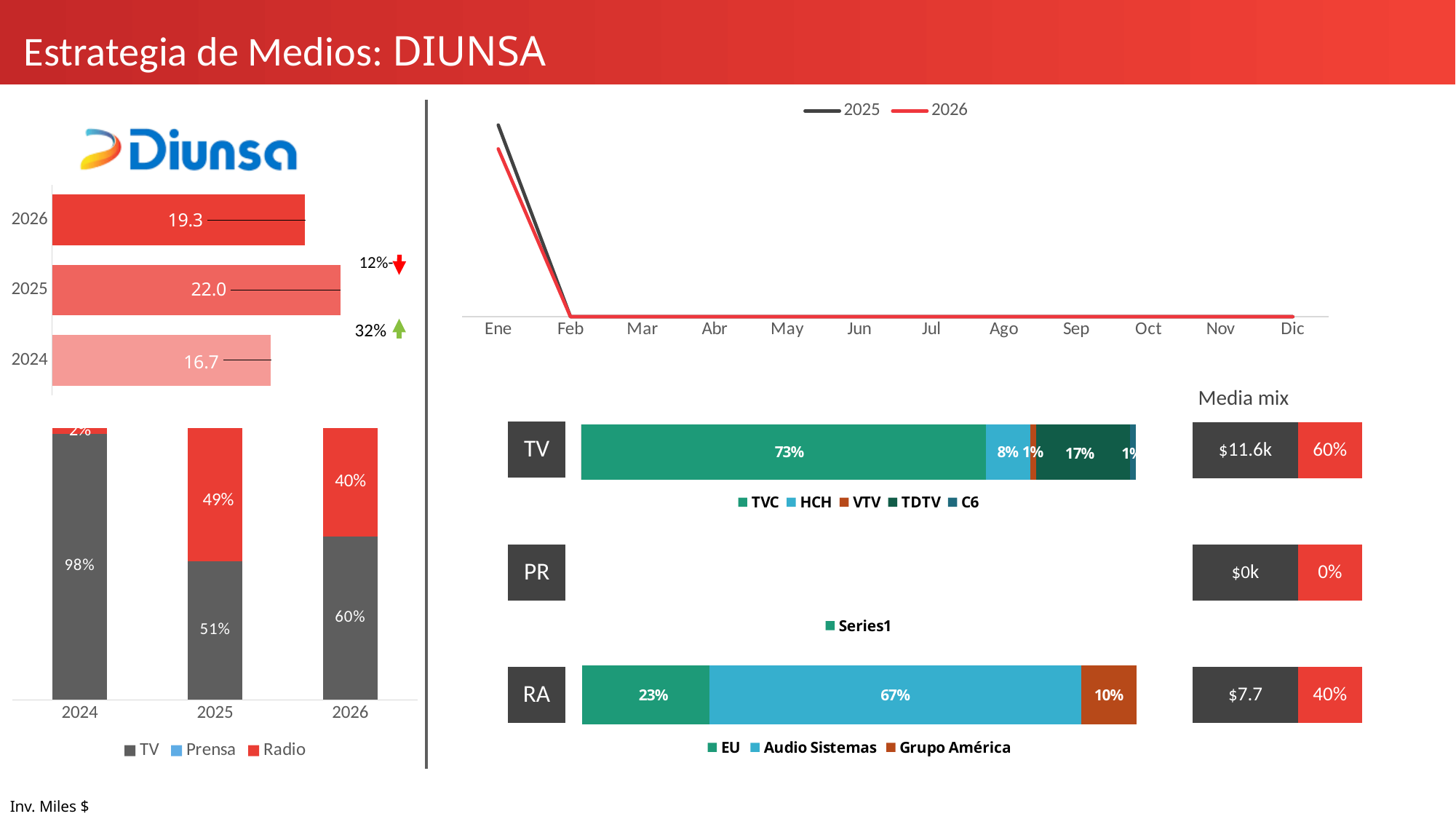
In the stacked bar chart at the bottom left, how many series does the legend list? 3 In the stacked bar chart at the bottom left, what is the Radio share for 2026? 40% In the stacked bar chart at the bottom left, which year has the highest TV share? 2024 In the horizontal bar chart on the left, what is the difference between the 2025 and 2026 values? 2.7 In the stacked bar chart at the bottom left, what is the TV share for 2025? 51% In the horizontal bar chart on the left, which year has the highest value? 2025 What kind of chart is the top-right chart showing 2025 and 2026 by month? Line chart In the horizontal bar chart on the left, what is the value for 2024? 16.7 In the horizontal bar chart on the left, what is the value for 2026? 19.3 In the TV stacked bar on the right, what is the share for TDTV? 17% In the RA stacked bar on the right, what is the difference between the Audio Sistemas and EU shares? 44% In the RA stacked bar on the right, which segment is the largest? Audio Sistemas